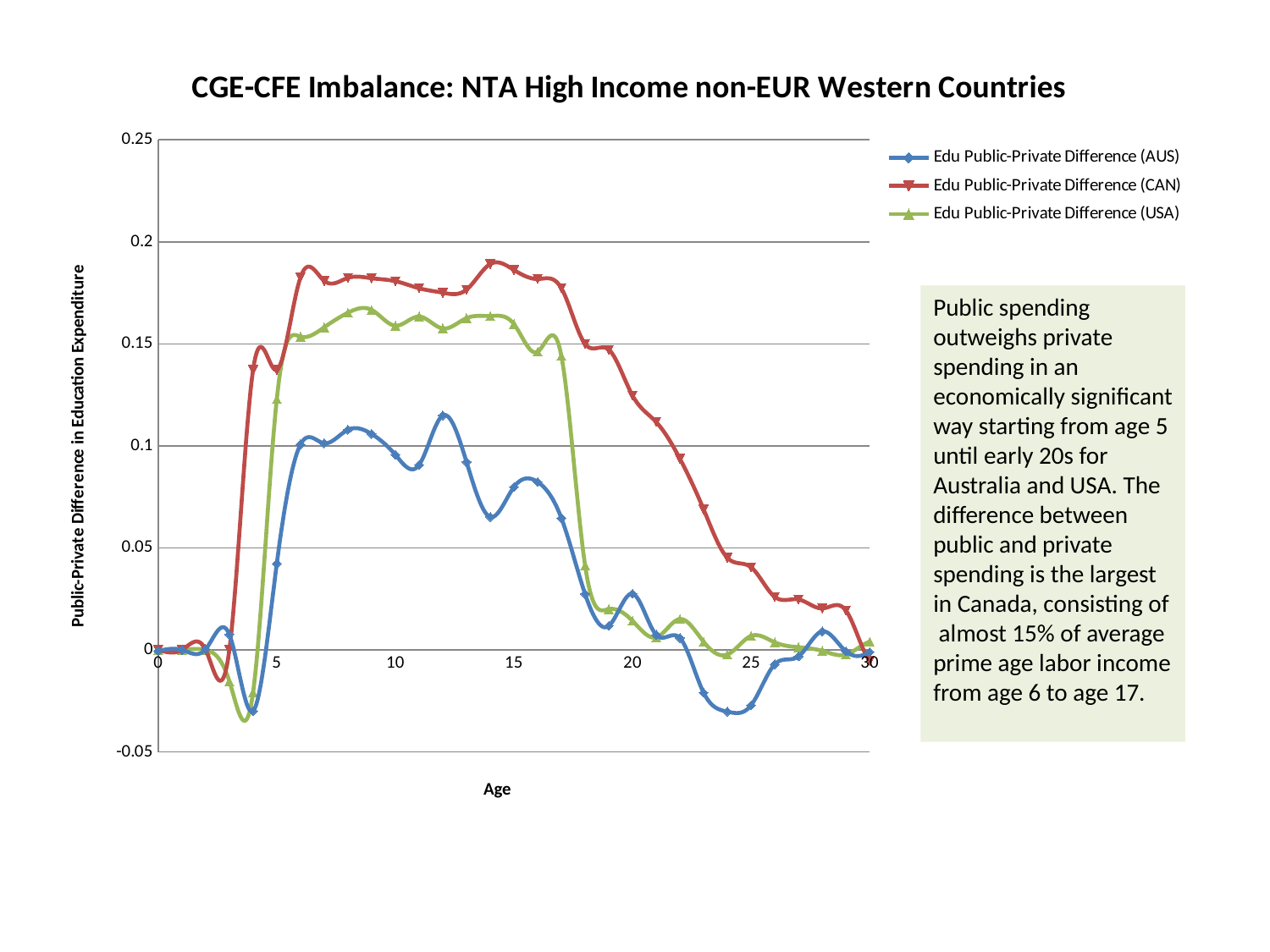
Is the value for Edu Public-Private Difference (CAN) at age 27 greater or less than 0.05? less Is the value for Edu Public-Private Difference (CAN) at age 10 greater or less than 0.15? greater Is the value for Edu Public-Private Difference (USA) at age 10 greater or less than 0.1? greater What is the label of the x axis? Age How many series does the legend list? 3 Which series has the highest value at age 10? Edu Public-Private Difference (CAN) What kind of chart is shown on the slide? line chart At age 20, which is larger: Edu Public-Private Difference (AUS) or Edu Public-Private Difference (CAN)? Edu Public-Private Difference (CAN) Does the Edu Public-Private Difference (CAN) series rise or fall from age 20 to age 30? fall What is the title of the chart? CGE-CFE Imbalance: NTA High Income non-EUR Western Countries Which series has the lowest value at age 24? Edu Public-Private Difference (AUS)